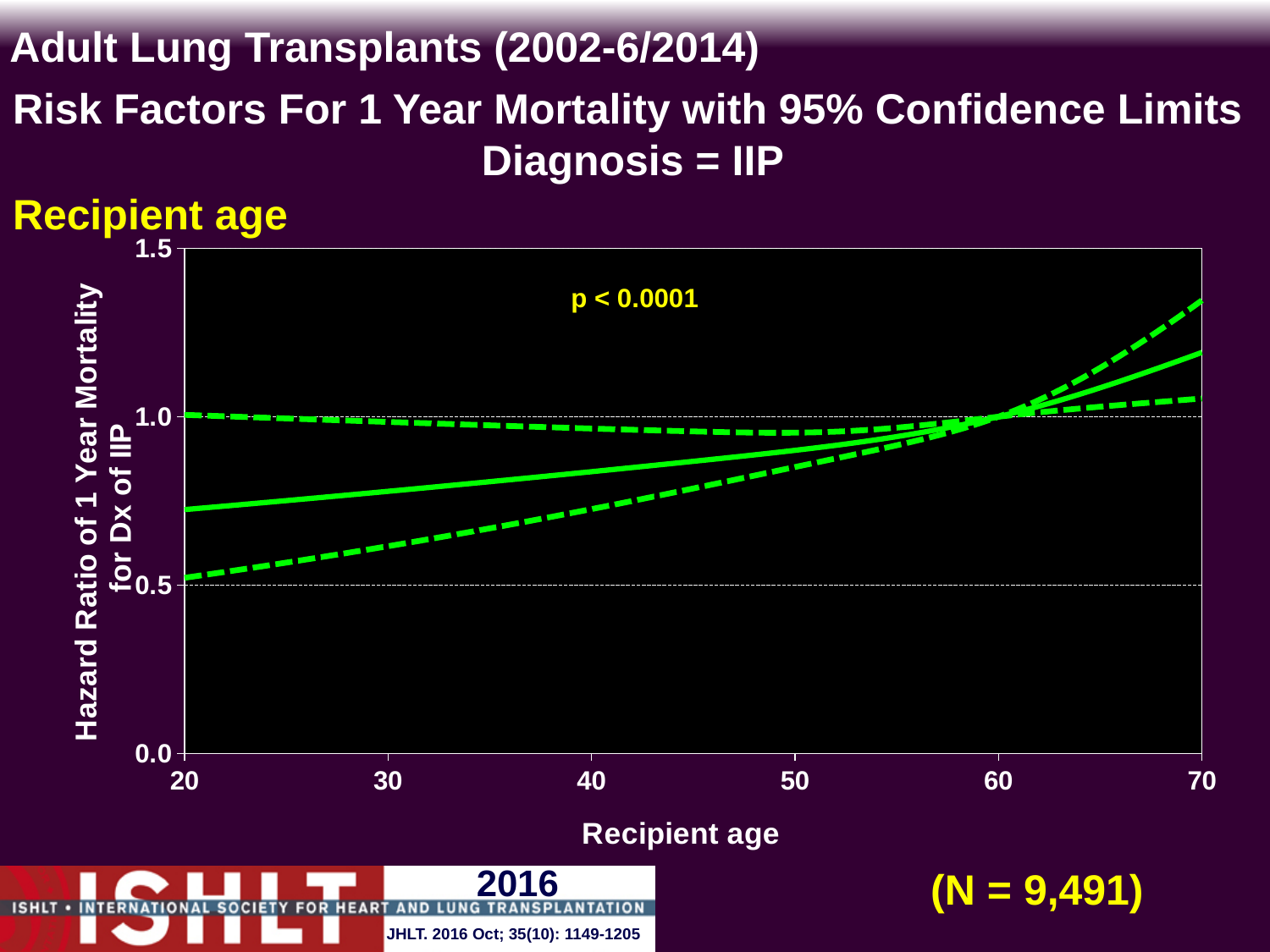
How many lines are plotted on the chart? 3 Does the hazard ratio (solid line) rise or fall as recipient age increases from 20 to 70? rise Is the upper 95% confidence limit (upper dashed line) at recipient age 70 greater or less than 1.0? greater Is the hazard ratio (solid line) at recipient age 70 greater or less than 1.0? greater What p-value is printed on the chart? p < 0.0001 Is the hazard ratio (solid line) at recipient age 20 greater or less than 0.5? greater What is the label of the x axis? Recipient age What kind of chart is shown on the slide? line chart What is the highest tick value shown on the y axis? 1.5 Is the hazard ratio (solid line) higher at recipient age 70 or at recipient age 20? 70